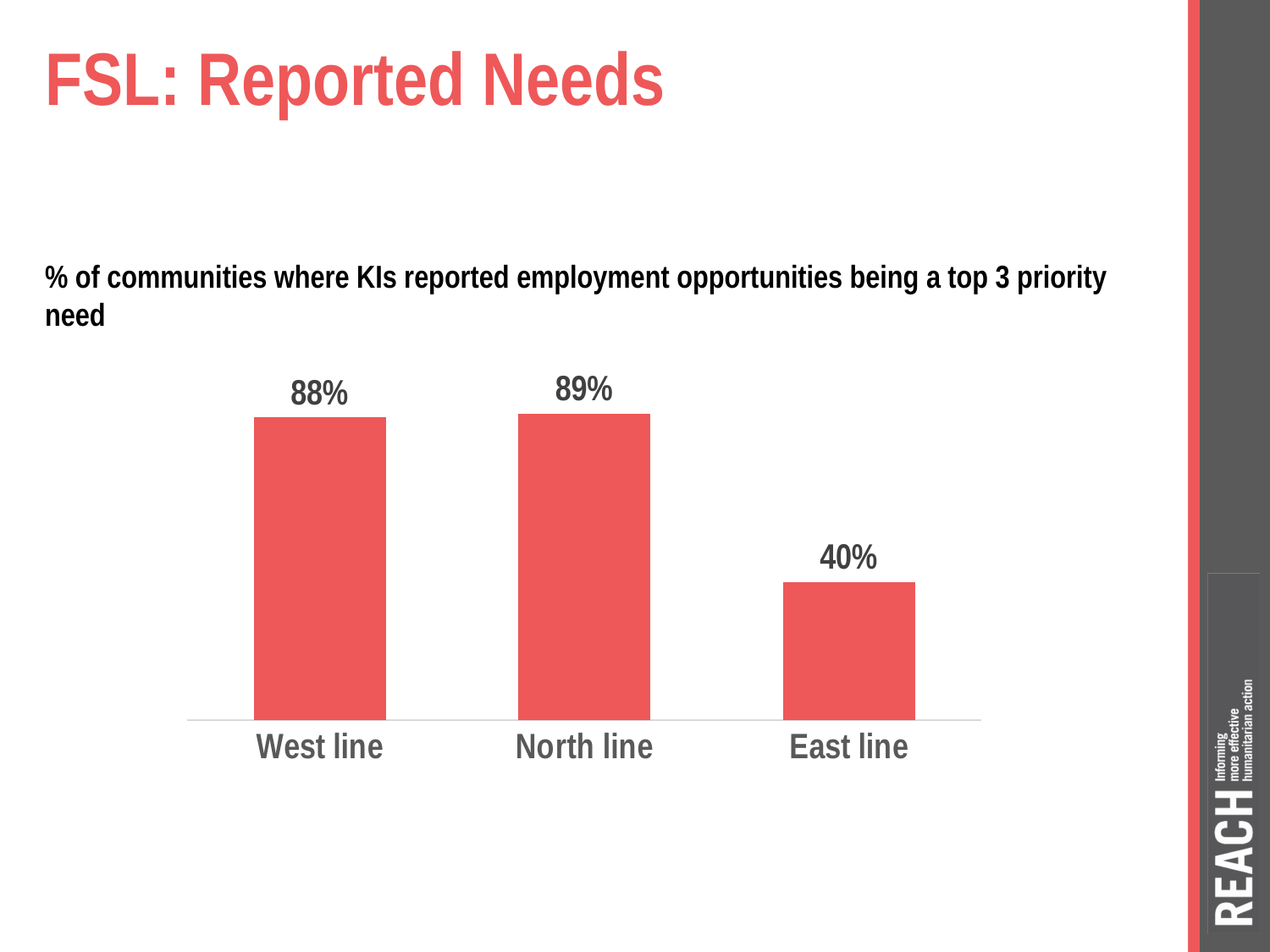
What colour are the bars in the chart? Red What is the title of the slide? FSL: Reported Needs Which is larger, the value for West line or the value for East line? West line What is the difference between the values for West line and East line? 48% Which category has the highest value? North line Which category has the lowest value? East line What kind of chart is shown on the slide? Bar chart How many categories are shown in the chart? 3 What is the value for West line? 88% What is the value for North line? 89% What is the value for East line? 40% What is the difference between the values for North line and East line? 49%